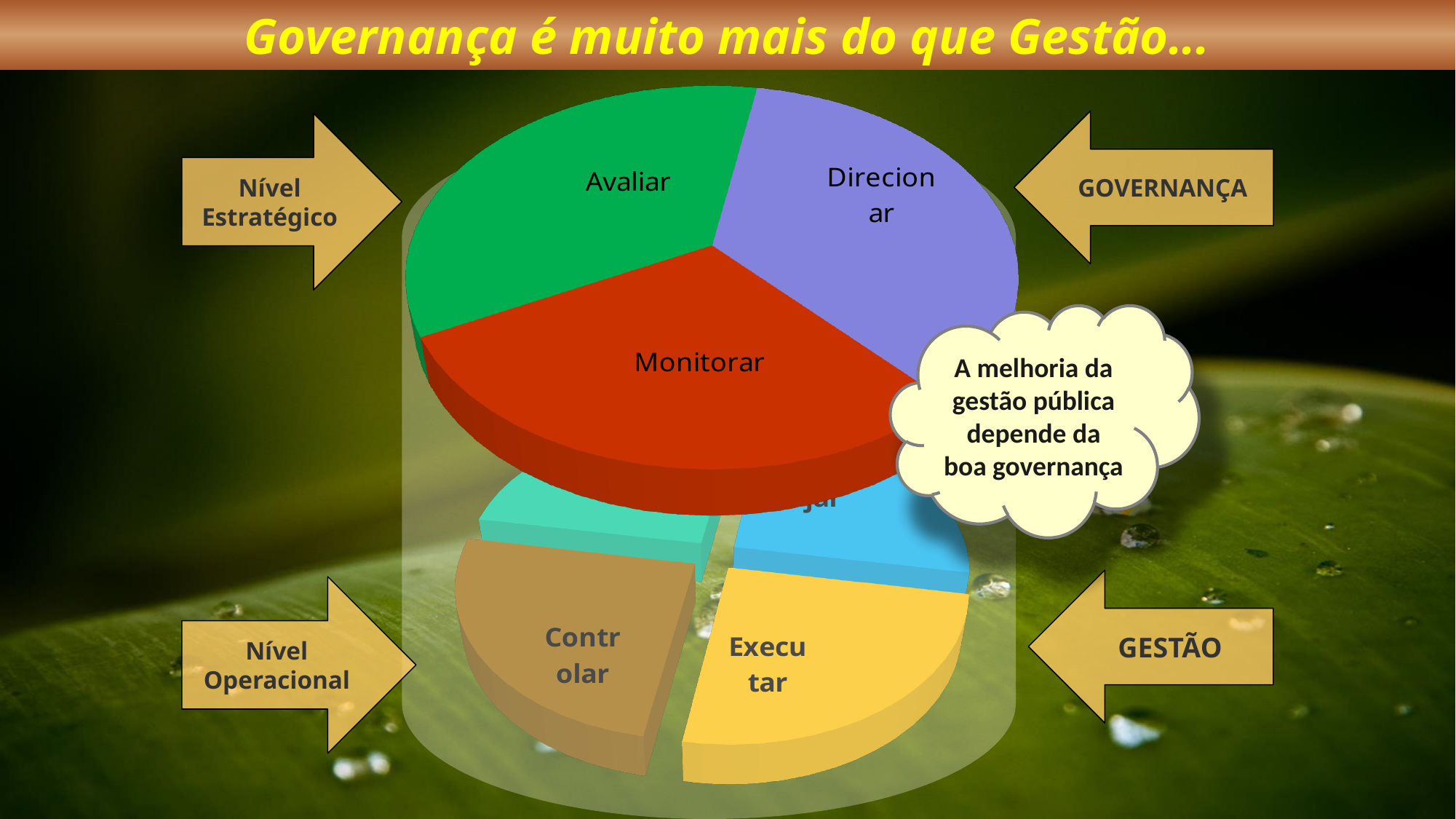
In the lower pie chart (GESTÃO), which slice is shown in brown? Controlar What kind of chart is the upper chart labelled GOVERNANÇA? Pie chart How many slices does the upper pie chart (GOVERNANÇA) have? 3 In the upper pie chart (GOVERNANÇA), what colour is the Monitorar slice? Red What kind of chart is the lower chart labelled GESTÃO? Pie chart In the lower pie chart (GESTÃO), which slice is shown in yellow? Executar In the upper pie chart (GOVERNANÇA), what colour is the Avaliar slice? Green